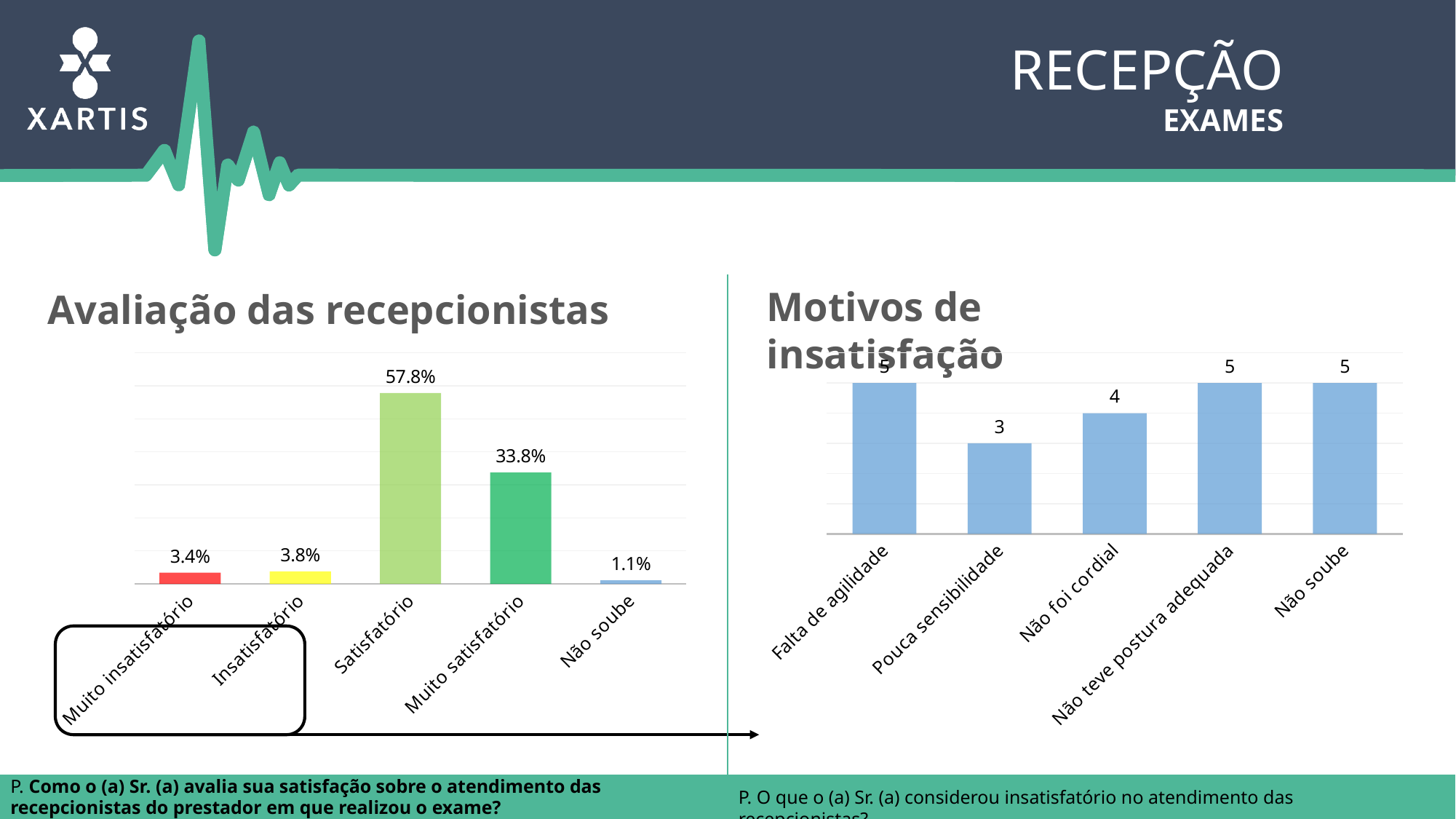
In the 'Avaliação das recepcionistas' chart, what is the difference between Satisfatório and Muito satisfatório? 24.0% In the 'Avaliação das recepcionistas' chart, what is the value for Não soube? 1.1% In the 'Avaliação das recepcionistas' chart, what is the value for Muito satisfatório? 33.8% How many categories are shown in the 'Avaliação das recepcionistas' chart? 5 In the 'Motivos de insatisfação' chart, what is the value for Pouca sensibilidade? 3 In the 'Motivos de insatisfação' chart, which category has the lowest value? Pouca sensibilidade What type of chart is the 'Motivos de insatisfação' chart? Bar chart In the 'Avaliação das recepcionistas' chart, which category has the highest value? Satisfatório In the 'Avaliação das recepcionistas' chart, which category has the lowest value? Não soube In the 'Motivos de insatisfação' chart, what is the value for Não foi cordial? 4 In the 'Avaliação das recepcionistas' chart, what is the value for Satisfatório? 57.8% In the 'Avaliação das recepcionistas' chart, which is larger: Muito insatisfatório or Insatisfatório? Insatisfatório